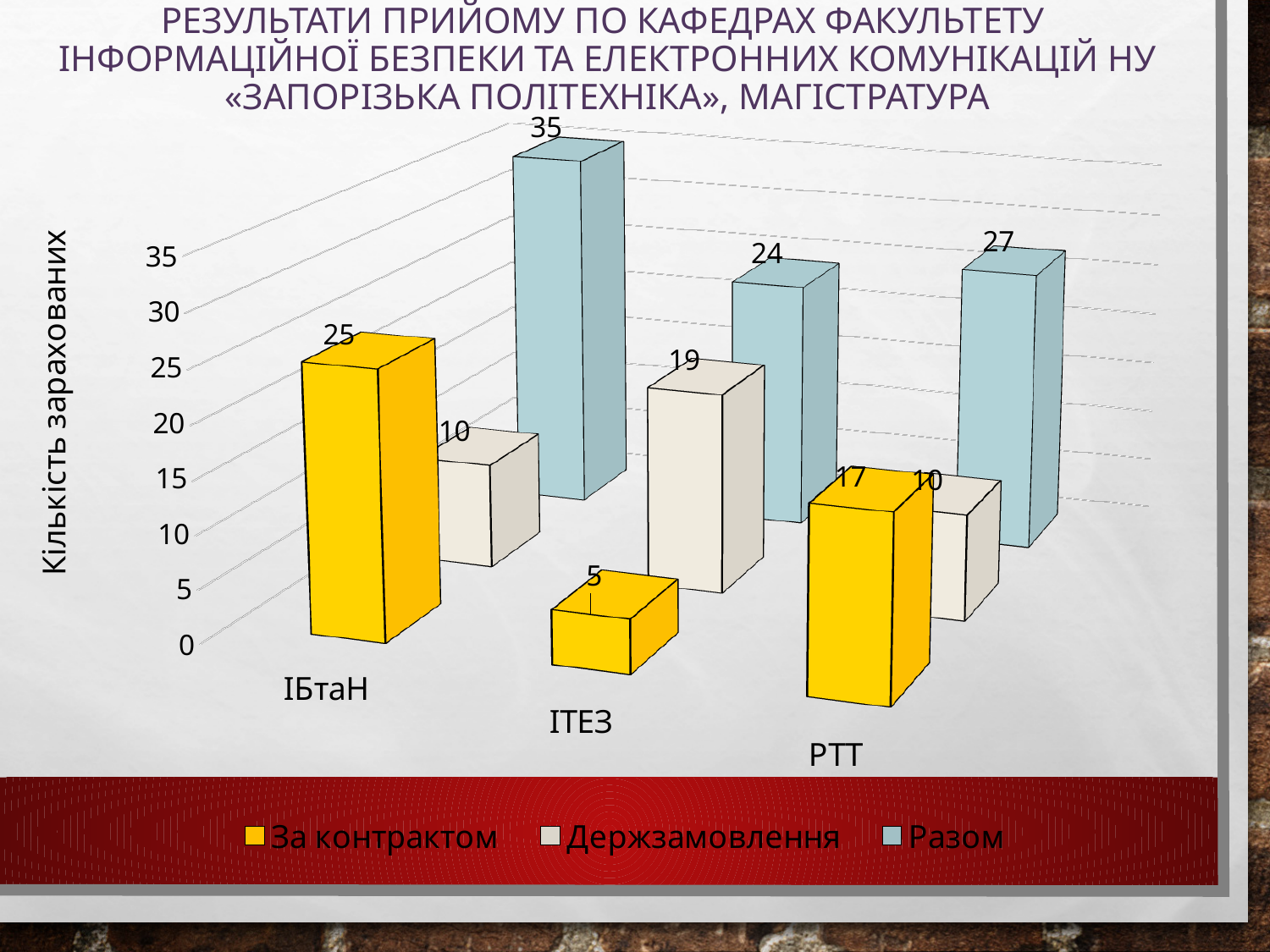
What is the value of За контрактом for ІБтаН? 25 Which category has the highest Разом value? ІБтаН Which is larger: За контрактом for РТТ or Держзамовлення for РТТ? За контрактом for РТТ What is the label of the vertical axis? Кількість зарахованих What is the difference between the Разом values for ІБтаН and ІТЕЗ? 11 What is the value of Разом for РТТ? 27 What is the value of Держзамовлення for ІТЕЗ? 19 Which category has the lowest За контрактом value? ІТЕЗ How many categories are shown on the x axis? 3 What is the value of За контрактом for ІТЕЗ? 5 How many series does the legend list? 3 What kind of chart is shown on the slide? Bar chart